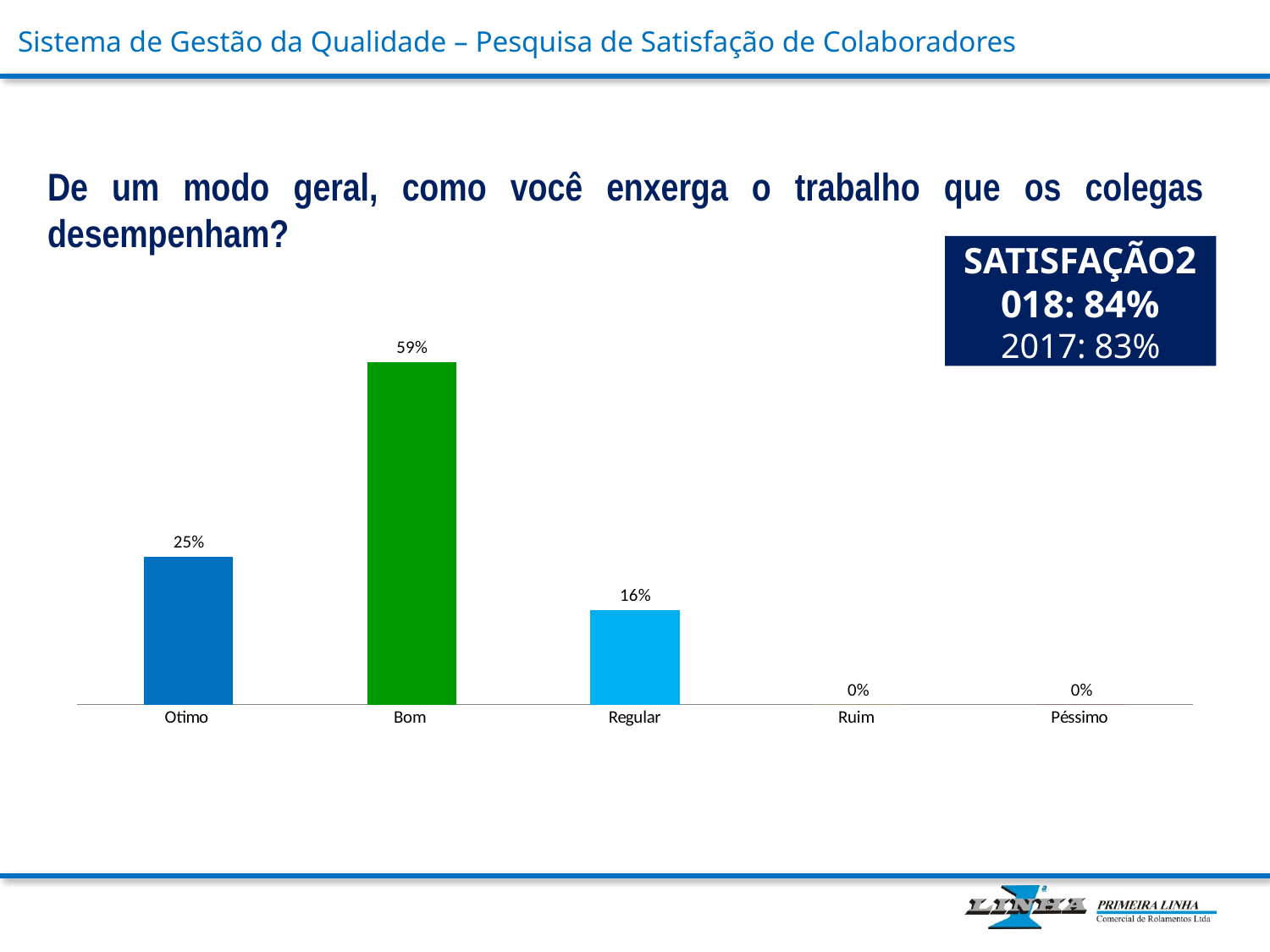
How many categories are shown on the x axis? 5 What is the value for Bom? 59% What is the value for Otimo? 25% What is the difference between the values for Otimo and Regular? 9% What is the difference between the values for Bom and Otimo? 34% What colour is the bar for Bom? Green What kind of chart is shown on the slide? Bar chart Which category has the highest value? Bom How many categories have a value of 0%? 2 What is the value for Regular? 16% Which is larger, the value for Otimo or the value for Regular? Otimo What is the value for Ruim? 0%